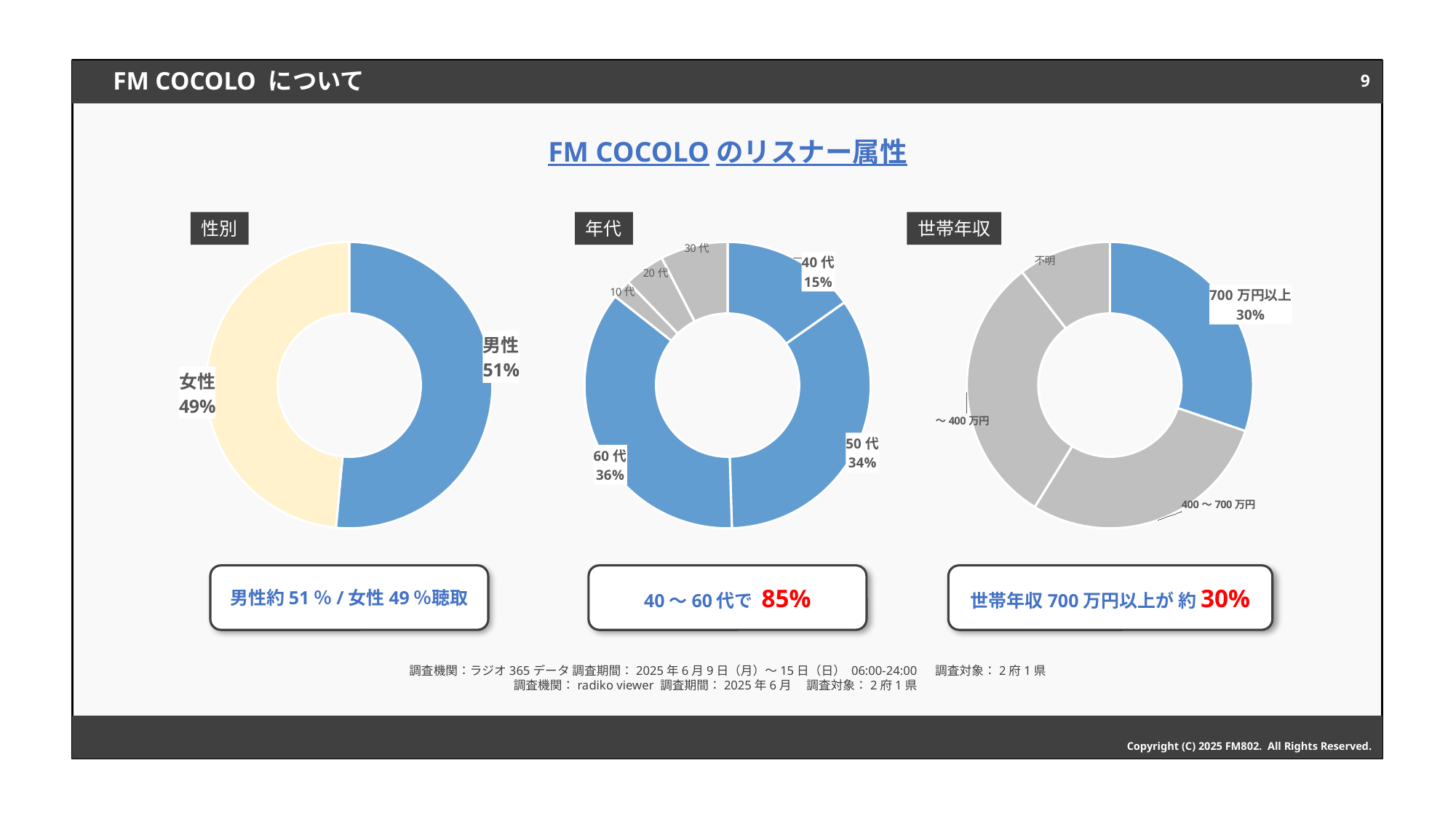
In the 世帯年収 chart, what percentage is 700 万円以上? 30% In the 年代 chart, which age group has the largest share? 60 代 In the 性別 chart, what is the difference between 男性 and 女性? 2% In the 年代 chart, what is the combined share of 40 代, 50 代 and 60 代? 85% In the 年代 chart, what percentage is 40 代? 15% In the 性別 chart, what percentage is 男性? 51% In the 年代 chart, what percentage is 60 代? 36% What kind of chart is used for the 世帯年収 data? Donut (pie) chart In the 年代 chart, what percentage is 50 代? 34% In the 年代 chart, how many age categories are shown? 6 In the 性別 chart, what percentage is 女性? 49% In the 性別 chart, which is larger, 男性 or 女性? 男性